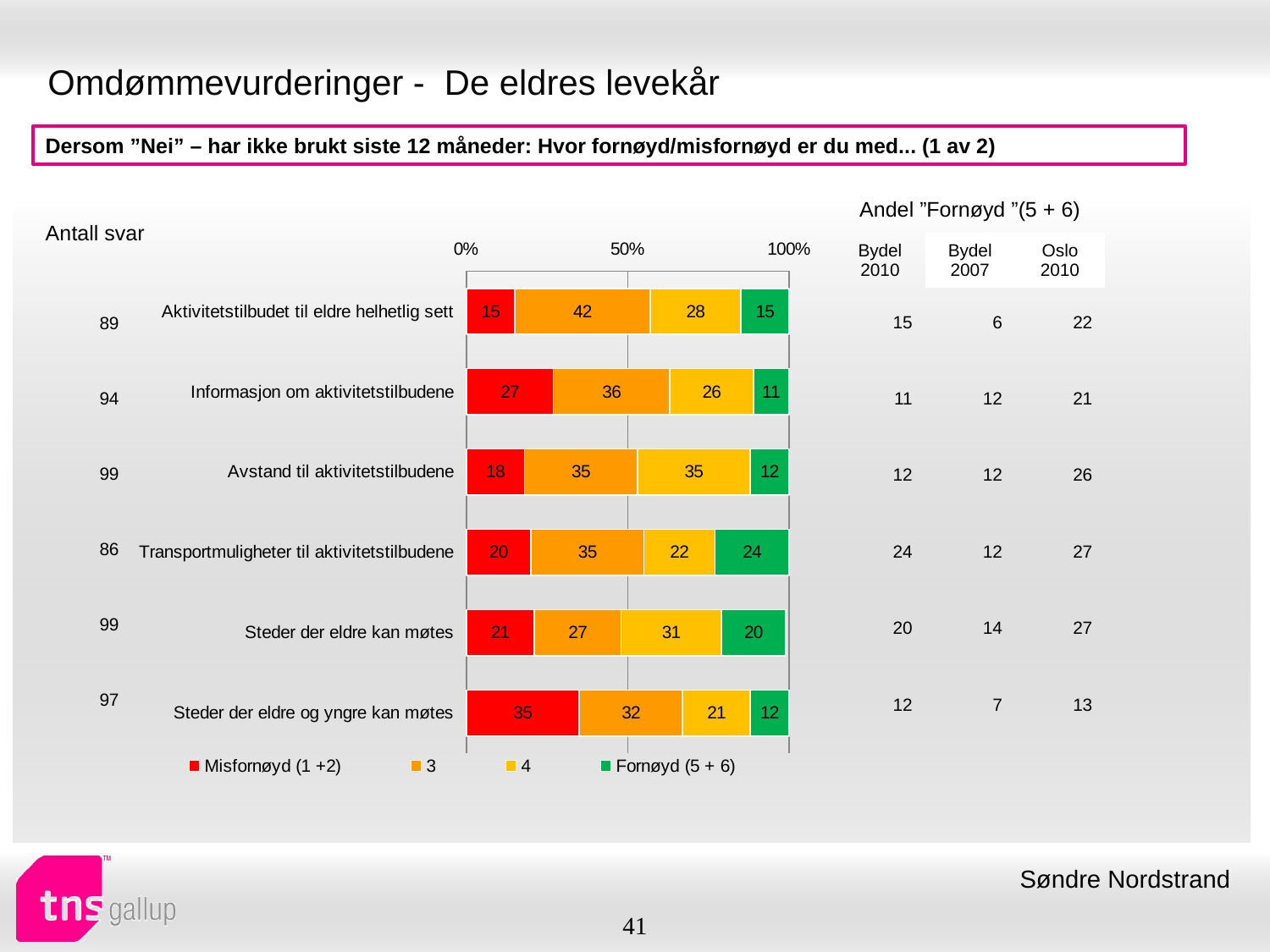
What is the value of the 'Misfornøyd (1 +2)' segment for 'Steder der eldre og yngre kan møtes'? 35 Which category has the highest 'Fornøyd (5 + 6)' value? Transportmuligheter til aktivitetstilbudene Which category has the lowest 'Misfornøyd (1 +2)' value? Aktivitetstilbudet til eldre helhetlig sett What is the value of the 'Fornøyd (5 + 6)' segment for 'Transportmuligheter til aktivitetstilbudene'? 24 How many categories are plotted in the chart? 6 What is the difference between the 'Misfornøyd (1 +2)' values for 'Steder der eldre og yngre kan møtes' and 'Informasjon om aktivitetstilbudene'? 8 What type of chart is shown on the slide? Stacked bar chart Which category has the highest 'Misfornøyd (1 +2)' value? Steder der eldre og yngre kan møtes Which is larger: the '4' segment for 'Steder der eldre kan møtes' or the '4' segment for 'Steder der eldre og yngre kan møtes'? Steder der eldre kan møtes What is the total of the stacked bar for 'Avstand til aktivitetstilbudene'? 100 How many series does the chart legend list? 4 What is the value of the '3' segment for 'Aktivitetstilbudet til eldre helhetlig sett'? 42